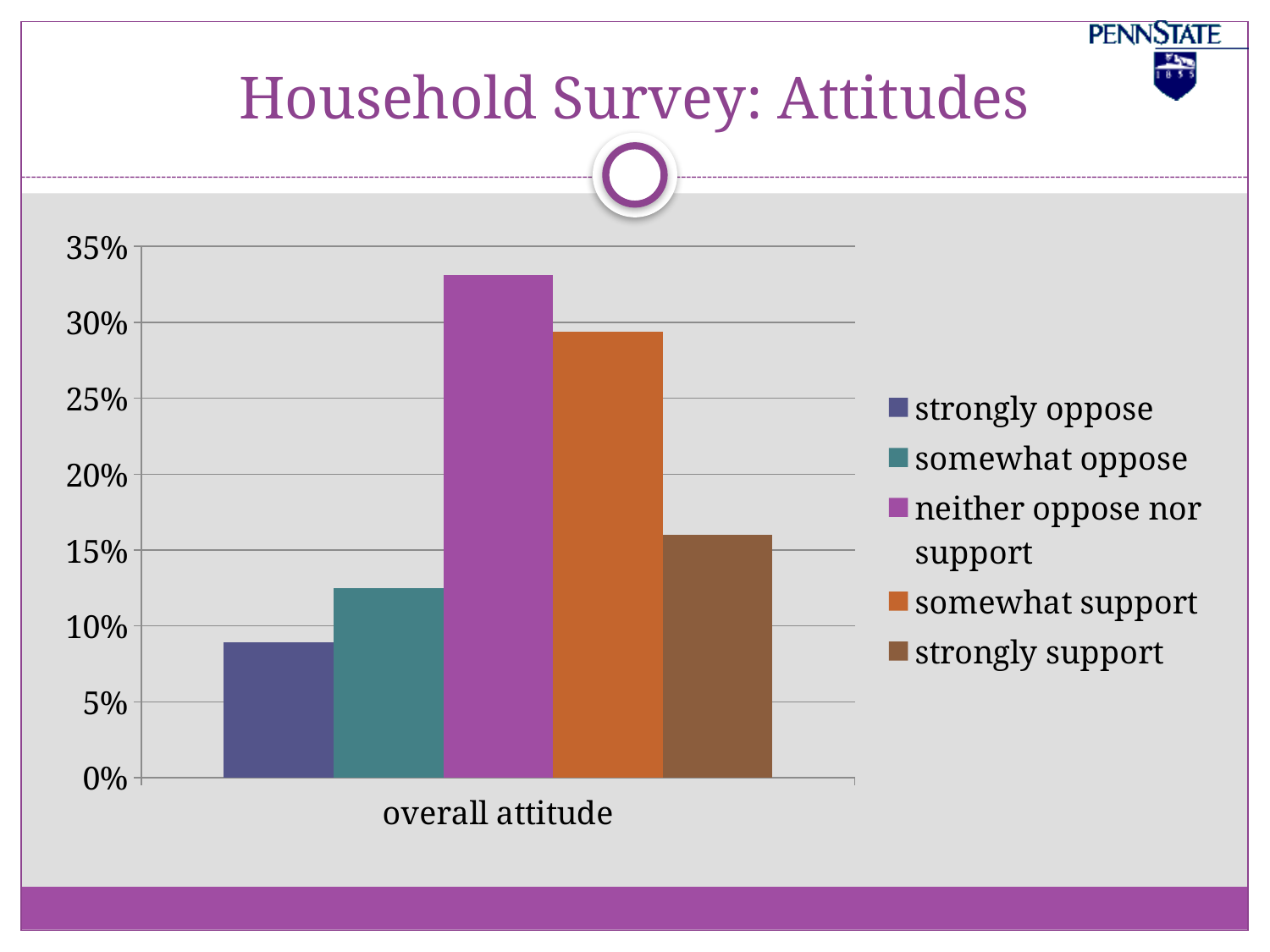
What is the label on the x axis of the chart? overall attitude What kind of chart is shown on the slide? bar chart How many series does the legend list? 5 Is the value for strongly support greater or less than 20%? less Is the value for strongly oppose greater or less than 10%? less Which series has the lowest value? strongly oppose Which series has the highest value? neither oppose nor support Is the value for somewhat support greater or less than 25%? greater How many categories are shown on the x axis? 1 Which is larger, the value for somewhat oppose or the value for strongly support? strongly support Which is larger, the value for neither oppose nor support or the value for somewhat support? neither oppose nor support